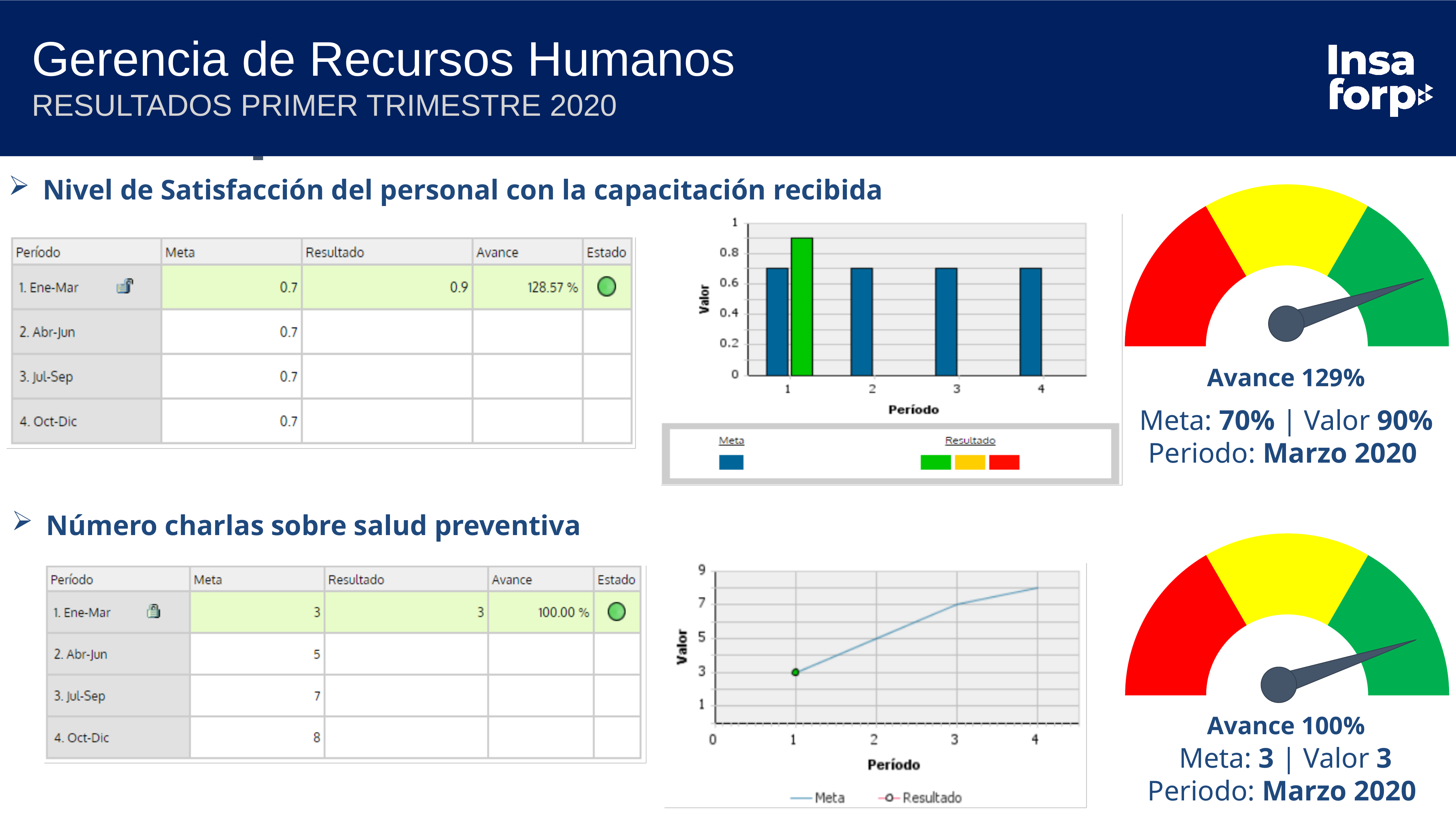
In the bottom line chart, what is the Resultado value for Período 1? 3 In the top bar chart, which is larger for Período 1, Meta or Resultado? Resultado In the top bar chart, is the Resultado value for Período 1 greater or less than 0.8? greater In the bottom line chart, does the Meta line rise or fall from Período 1 to Período 4? rise In the top bar chart, what is the Meta value for Período 1? 0.7 What kind of chart is the top chart, next to the 'Nivel de Satisfacción del personal con la capacitación recibida' table? bar chart How many series does the legend of the bottom line chart list? 2 In the top bar chart, how many períodos are shown on the x axis? 4 In the bottom line chart, what is the Meta value for Período 4? 8 What kind of chart is the bottom chart, next to the 'Número charlas sobre salud preventiva' table? line chart In the top bar chart, what is the difference between Resultado and Meta for Período 1? 0.2 In the top bar chart, what is the Resultado value for Período 1? 0.9